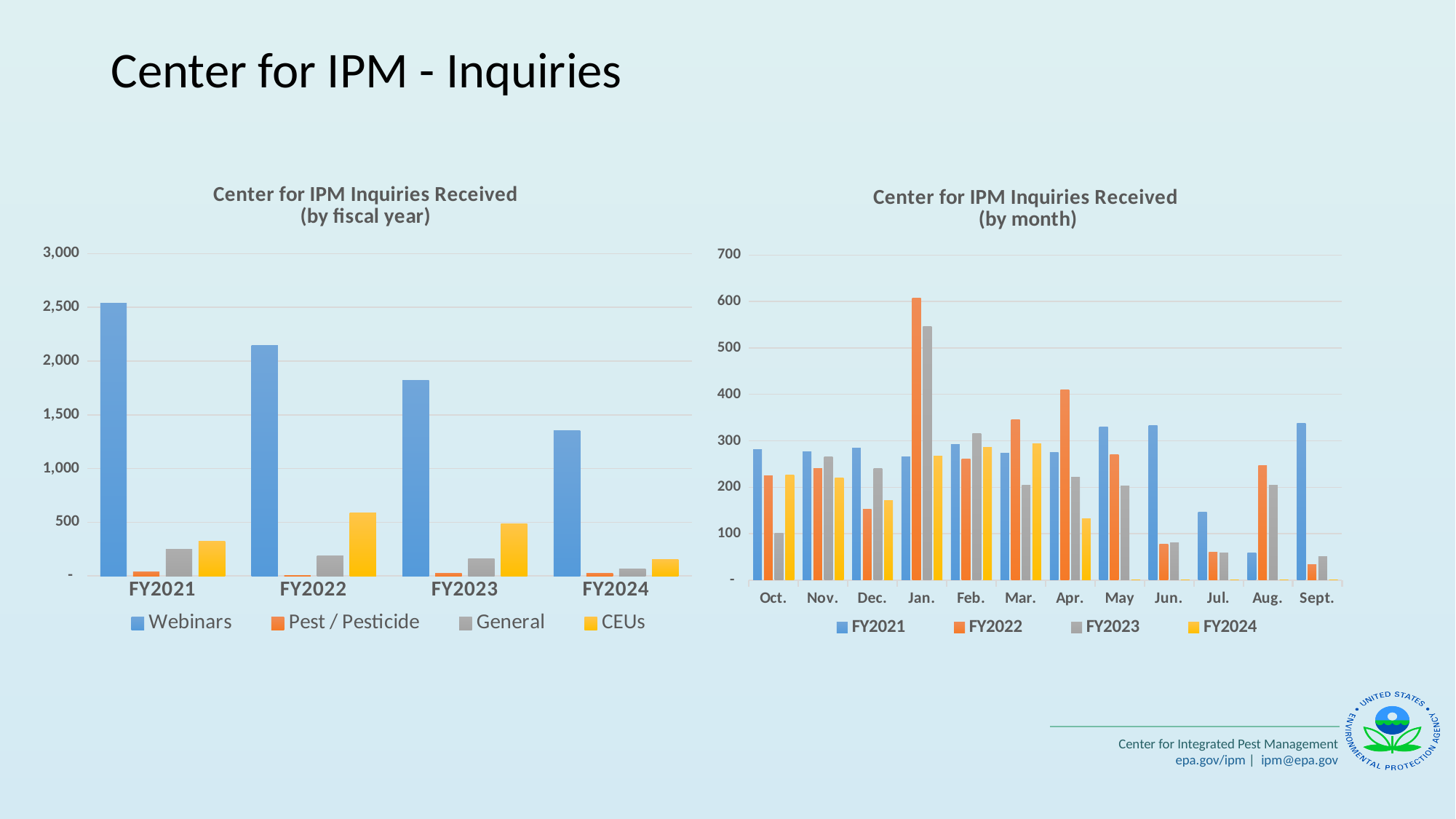
In the 'Center for IPM Inquiries Received (by fiscal year)' chart, which fiscal year has the highest Webinars value? FY2021 In the 'Center for IPM Inquiries Received (by month)' chart, how many months are shown on the x axis? 12 In the 'Center for IPM Inquiries Received (by fiscal year)' chart, is the CEUs value for FY2022 greater or less than 500? greater In the 'Center for IPM Inquiries Received (by month)' chart, which month has the highest FY2022 value? Jan. In the 'Center for IPM Inquiries Received (by fiscal year)' chart, how many fiscal years are shown on the x axis? 4 In the 'Center for IPM Inquiries Received (by month)' chart, is the FY2021 value for Jul. greater or less than 200? less In the 'Center for IPM Inquiries Received (by fiscal year)' chart, is the Webinars value for FY2021 greater or less than 2,500? greater In the 'Center for IPM Inquiries Received (by fiscal year)' chart, how many series does the legend list? 4 In the 'Center for IPM Inquiries Received (by fiscal year)' chart, which is larger for FY2022: CEUs or General? CEUs What kind of chart is the 'Center for IPM Inquiries Received (by fiscal year)' chart? bar chart In the 'Center for IPM Inquiries Received (by fiscal year)' chart, do the Webinars values rise or fall from FY2021 to FY2024? fall